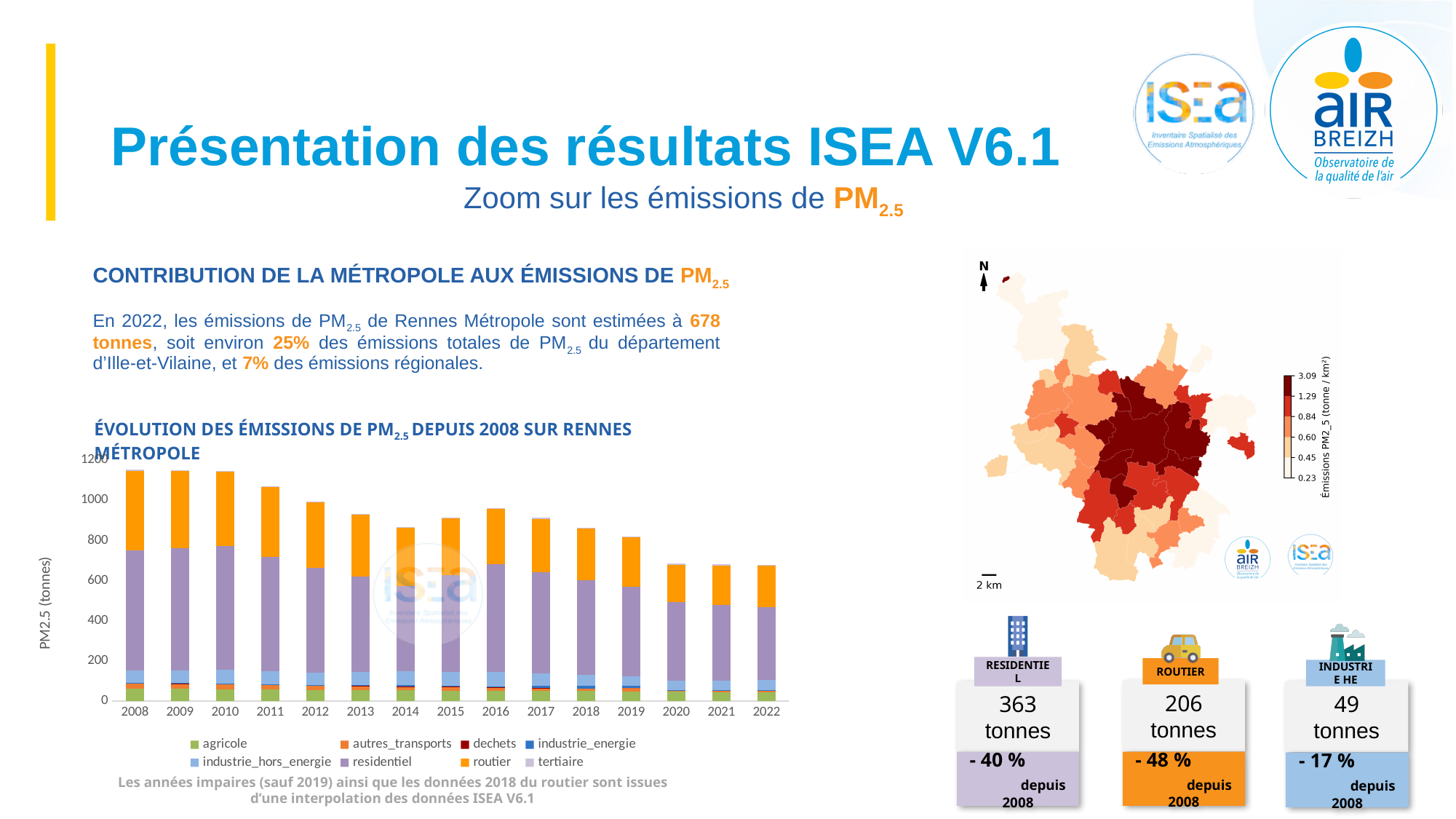
In the legend of the PM2.5 emissions evolution chart, which series is shown in orange (the large upper segment of each bar)? routier What is the label of the y axis on the PM2.5 emissions evolution chart? PM2.5 (tonnes) How many series does the legend of the PM2.5 emissions evolution chart list? 8 In the PM2.5 emissions evolution chart, which year has the larger total bar, 2008 or 2022? 2008 In the PM2.5 emissions evolution chart, is the total bar for 2020 greater or less than 800? less What kind of chart is used to show the evolution of PM2.5 emissions on Rennes Métropole since 2008? Stacked bar chart In the PM2.5 emissions evolution chart, do total emissions generally rise or fall from 2008 to 2022? fall In the PM2.5 emissions evolution chart, is the total bar for 2008 greater or less than 1000? greater How many years are shown on the x axis of the PM2.5 emissions evolution chart? 15 In the PM2.5 emissions evolution chart, is the total bar for 2014 greater or less than 1000? less